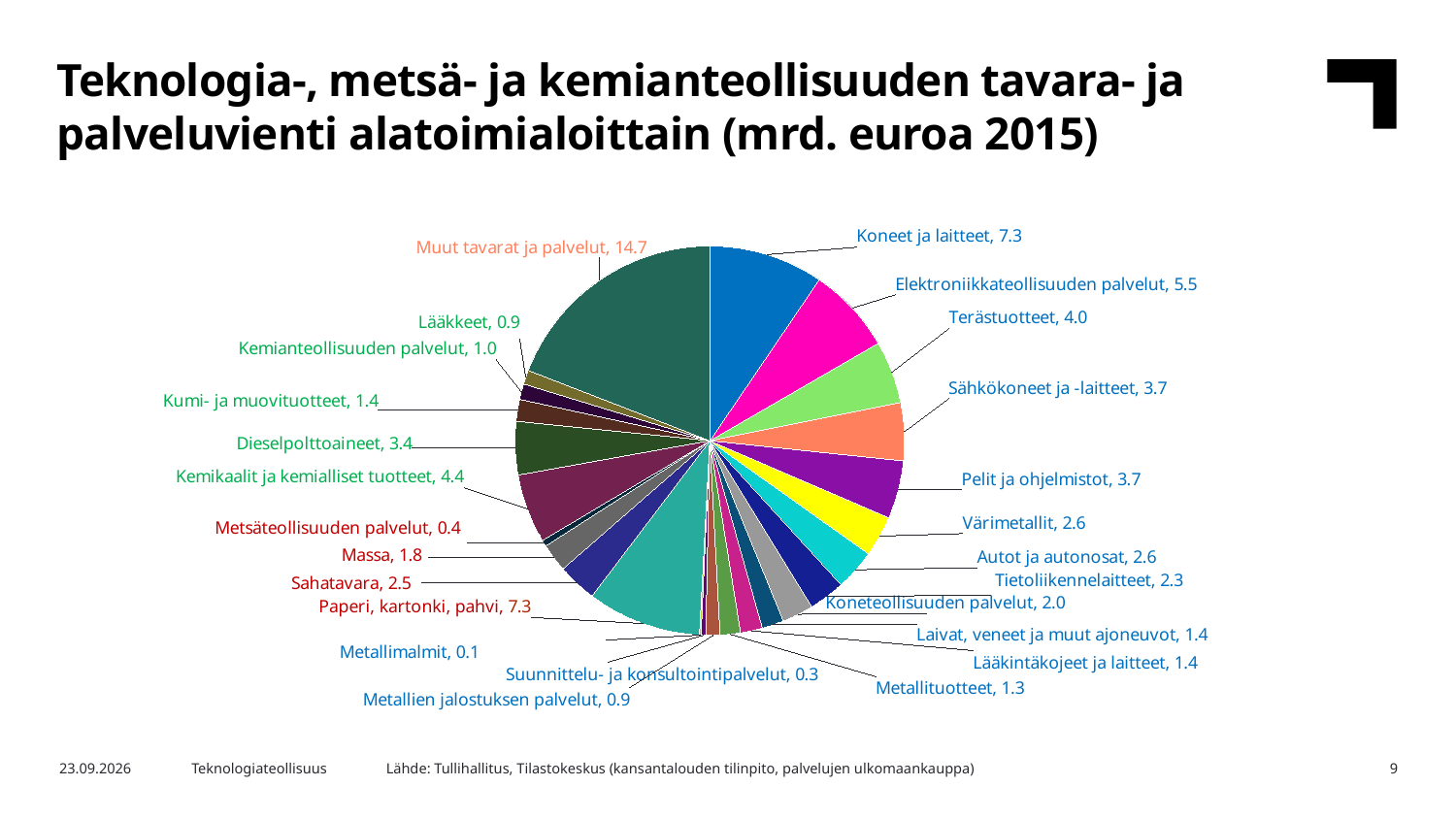
What is the value for Kemikaalit ja kemialliset tuotteet? 4.4 Which is larger, Sahatavara or Tietoliikennelaitteet? Sahatavara What is the value for Paperi, kartonki, pahvi? 7.3 How many slices does the pie chart have? 25 What is the difference between Terästuotteet and Dieselpolttoaineet? 0.6 What is the value for Koneet ja laitteet? 7.3 What is the difference between Muut tavarat ja palvelut and Koneet ja laitteet? 7.4 Which slice has the largest value? Muut tavarat ja palvelut What unit and year does the chart title state the values are in? mrd. euroa 2015 What type of chart is shown on the slide? Pie chart Which slice has the smallest value? Metallimalmit What is the value for Elektroniikkateollisuuden palvelut? 5.5